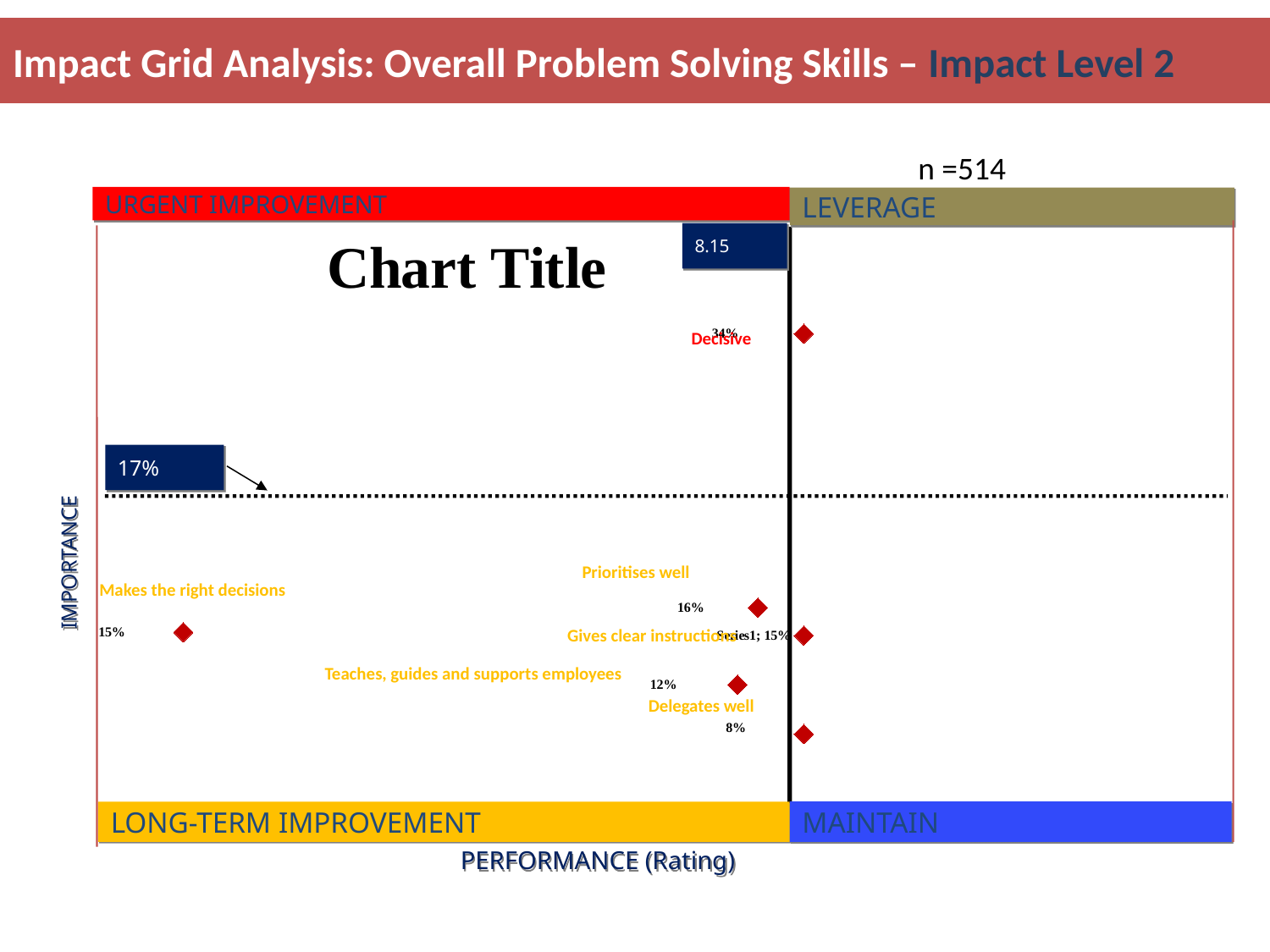
What is the difference between the values for Decisive and Delegates well? 26% Which point has the highest labelled value? Decisive What value is shown for Teaches, guides and supports employees? 12% What value is shown for Makes the right decisions? 15% How many data points are plotted on the chart? 6 What kind of chart is shown on the slide? Scatter chart Which has the larger value, Prioritises well or Teaches, guides and supports employees? Prioritises well Which point has the lowest labelled value? Delegates well What is the label of the horizontal axis? PERFORMANCE (Rating) What is the data label value for the Decisive point? 34% What value is shown for Delegates well? 8% What value is shown for Prioritises well? 16%